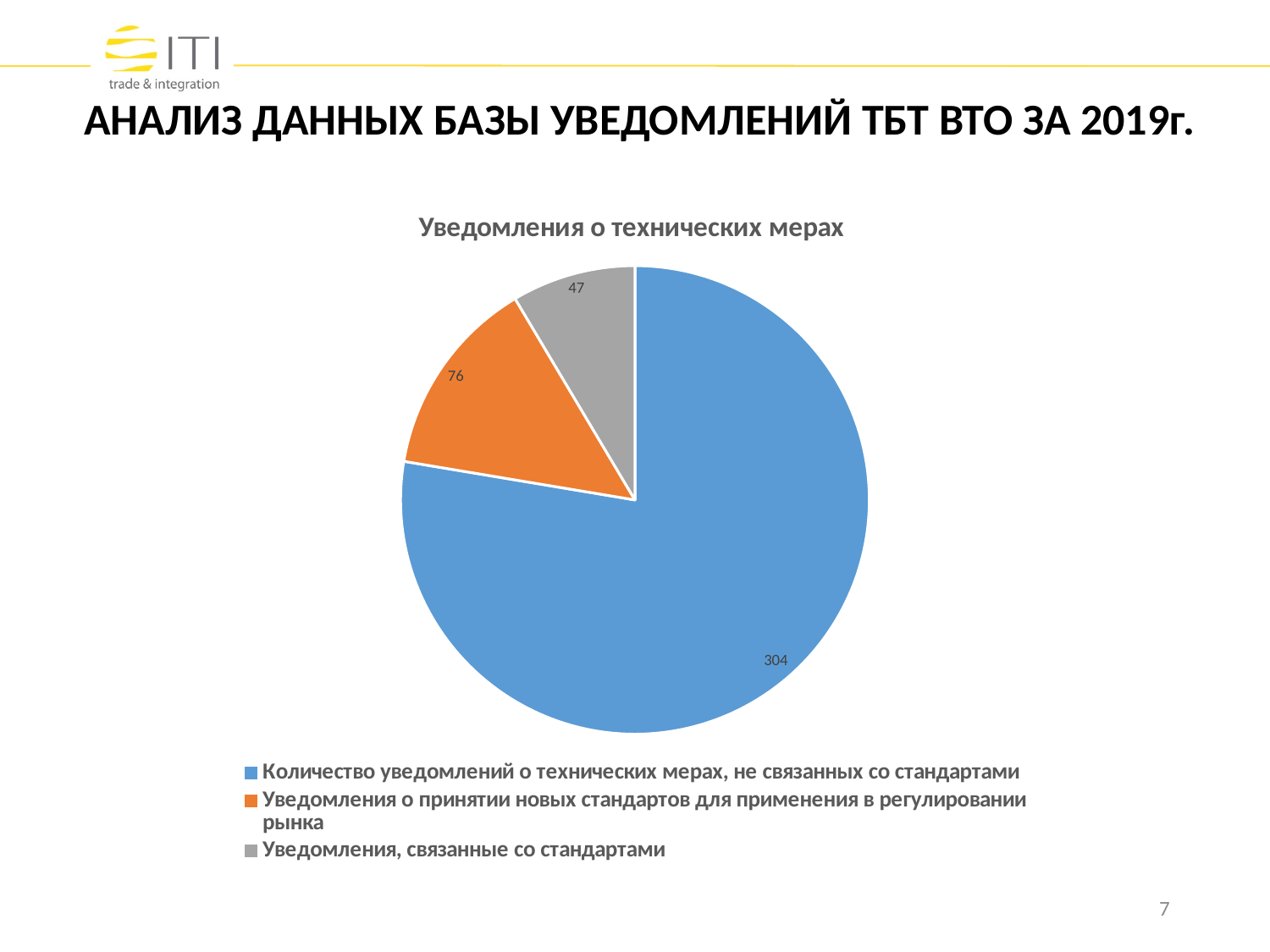
What is the total of all slices in the pie chart? 427 Which category has the smallest slice? Уведомления, связанные со стандартами Which is larger: the value for "Уведомления о принятии новых стандартов для применения в регулировании рынка" or the value for "Уведомления, связанные со стандартами"? Уведомления о принятии новых стандартов для применения в регулировании рынка What is the value for "Количество уведомлений о технических мерах, не связанных со стандартами"? 304 How many slices does the pie chart have? 3 How many entries does the legend list? 3 What is the title of the chart? Уведомления о технических мерах Which category has the largest slice? Количество уведомлений о технических мерах, не связанных со стандартами What is the value for "Уведомления о принятии новых стандартов для применения в регулировании рынка"? 76 What is the value for "Уведомления, связанные со стандартами"? 47 What type of chart is shown on the slide? Pie chart What is the difference between the value for "Уведомления о принятии новых стандартов для применения в регулировании рынка" and the value for "Уведомления, связанные со стандартами"? 29